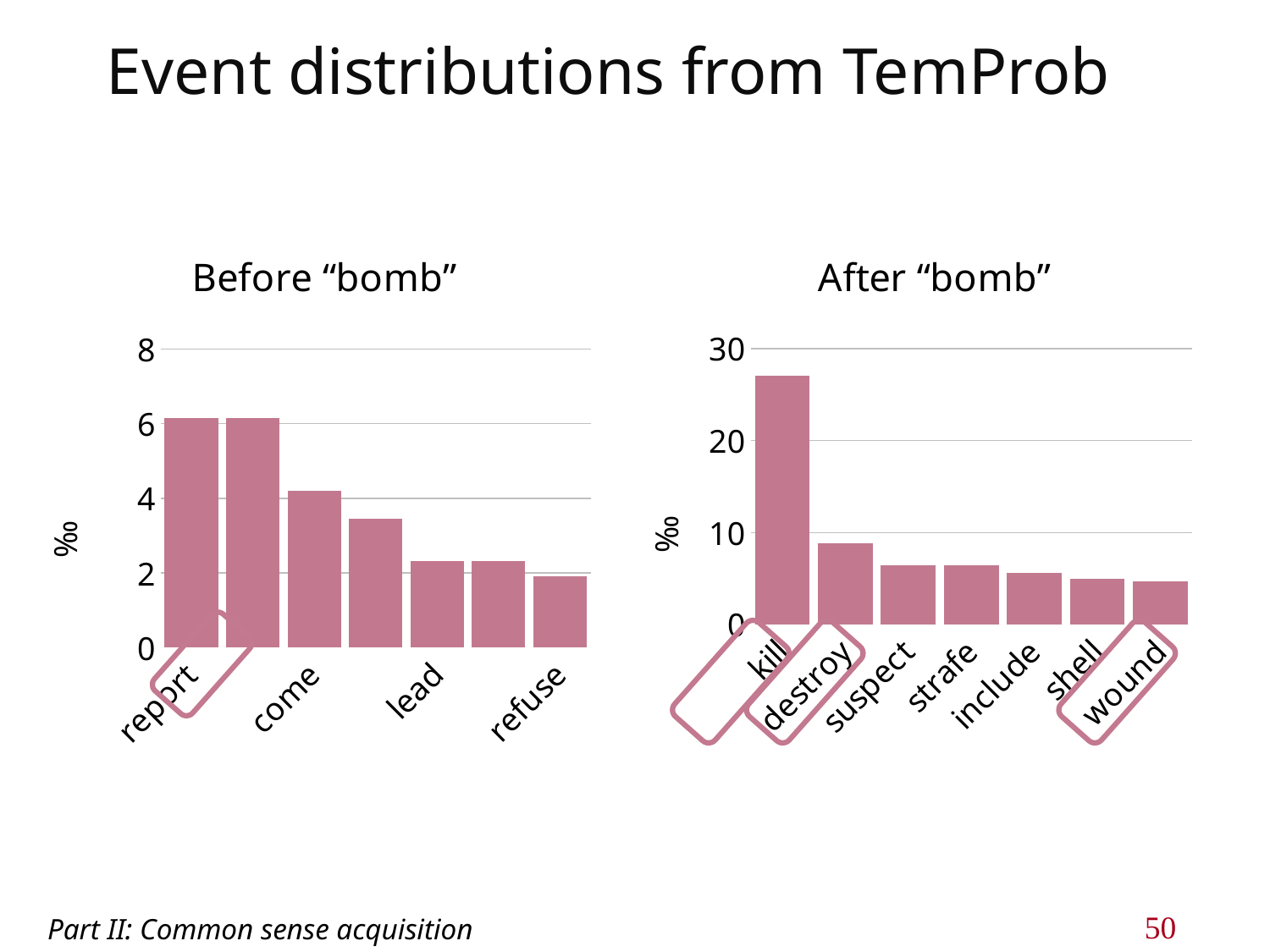
How many bars are shown in the "Before "bomb"" chart? 7 In the "After "bomb"" chart, which category has the highest value? kill In the "After "bomb"" chart, which is larger, the value for kill or the value for destroy? kill In the "Before "bomb"" chart, is the value for report greater or less than 4? greater In the "After "bomb"" chart, is the value for destroy greater or less than 10? less How many categories are shown in the "After "bomb"" chart? 7 What kind of chart is the "After "bomb"" chart? bar chart What is the y-axis label on the "Before "bomb"" chart? ‰ In the "Before "bomb"" chart, is the value for lead greater or less than 4? less In the "After "bomb"" chart, do the values rise or fall from left to right? fall In the "Before "bomb"" chart, which is larger, the value for report or the value for come? report